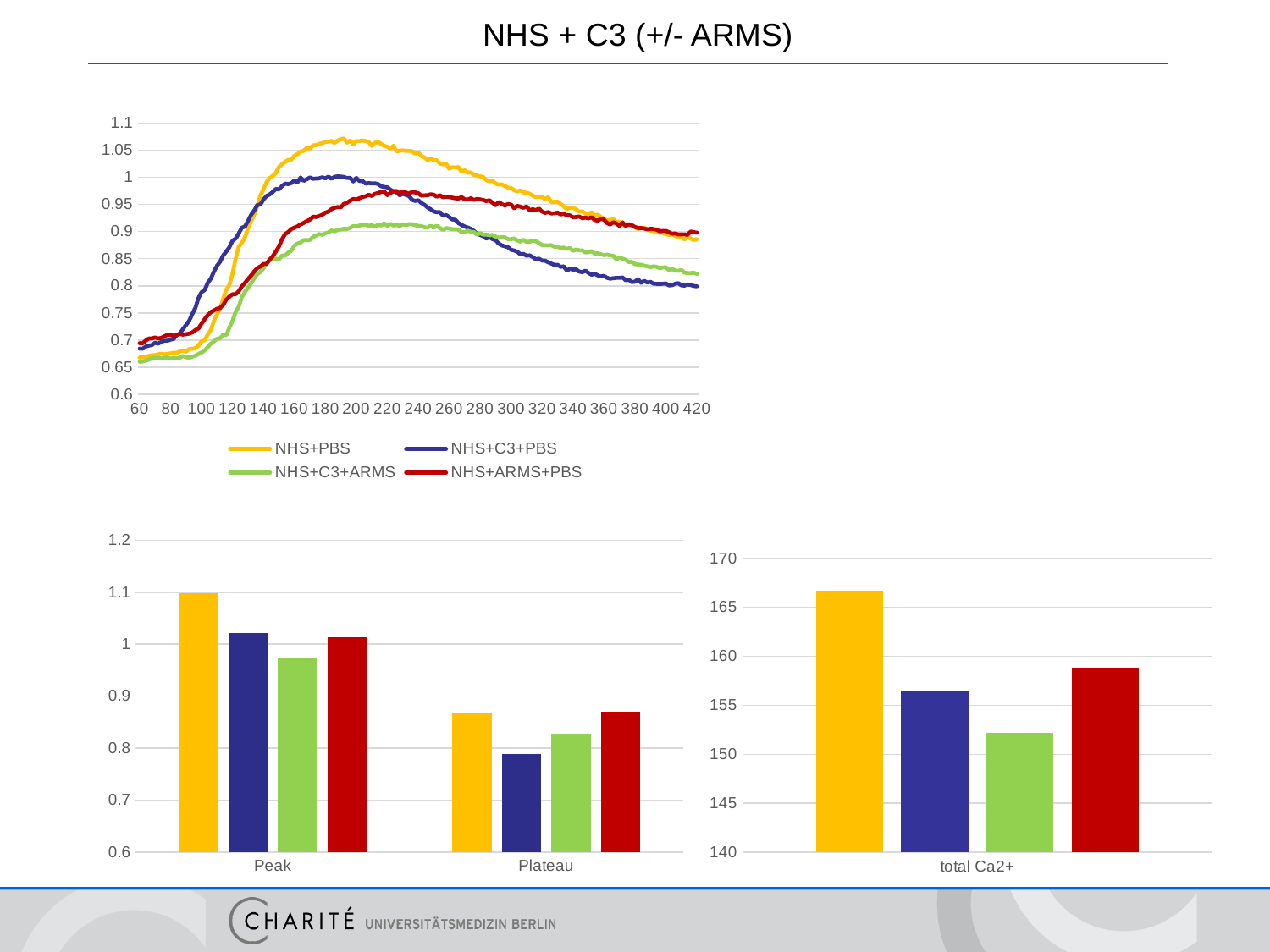
What kind of chart is the bottom-left chart with the categories Peak and Plateau? bar chart In the top line chart, which series reaches the highest value? NHS+PBS In the bottom-left bar chart, is the yellow bar for Peak greater or less than 1? greater In the bottom-left bar chart, which of the yellow bars is larger, the one for Peak or the one for Plateau? Peak What kind of chart is the top chart on the slide? line chart In the top line chart, is the value of NHS+PBS at x = 180 greater or less than 1? greater In the bottom-right bar chart (total Ca2+), is the yellow bar greater or less than 160? greater How many series does the legend of the top line chart list? 4 In the bottom-right bar chart (total Ca2+), which bar is the lowest? the green bar How many categories are shown on the x axis of the bottom-left bar chart? 2